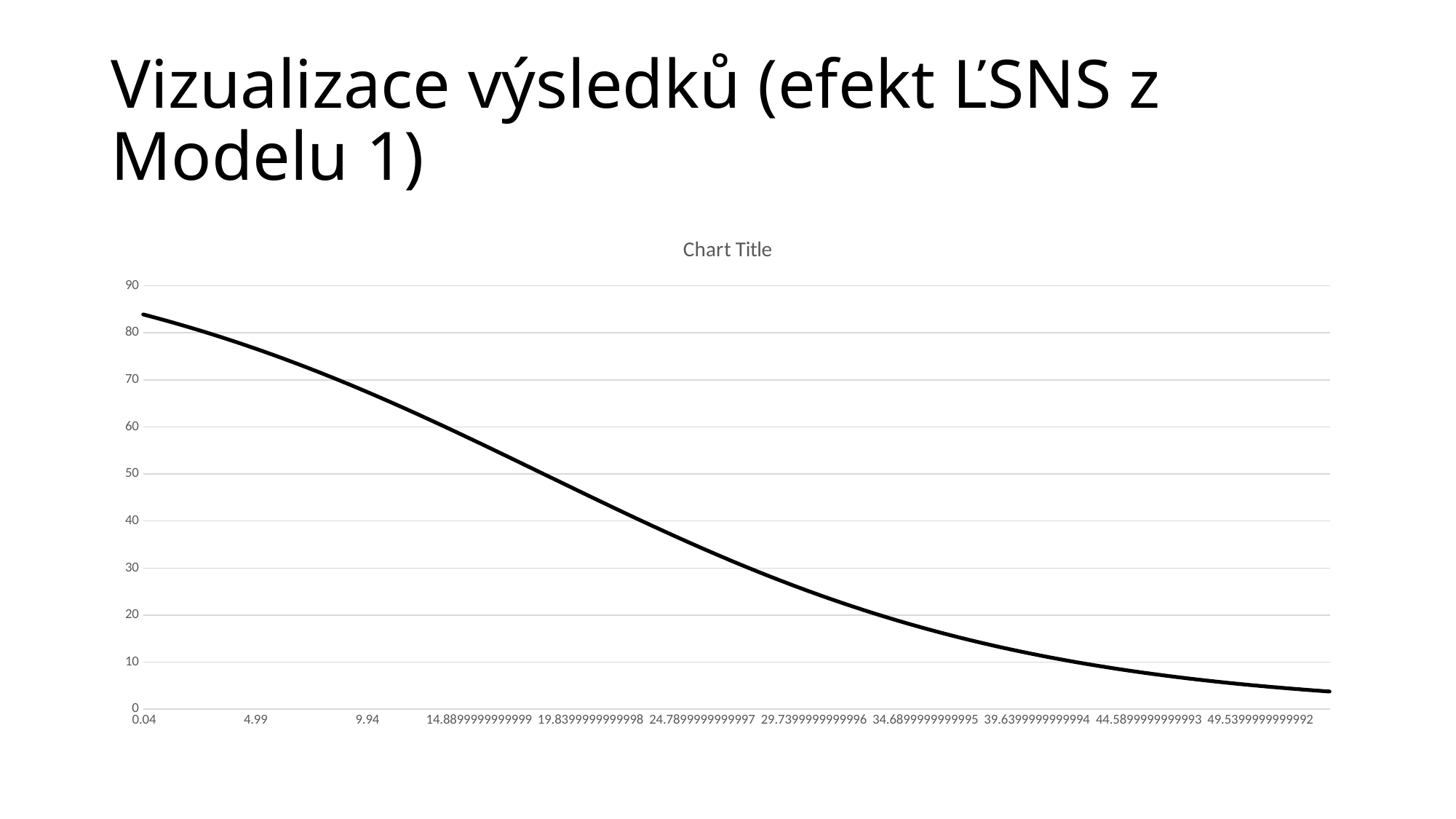
Is the value at x = 29.7399999999996 greater or less than 40? less Is the value at x = 9.94 greater or less than 80? less Is the value at x = 0.04 greater or less than 90? less What is the title printed above the chart? Chart Title Do the values rise or fall as you move from left to right along the x axis? fall What kind of chart is shown on the slide? line chart How many tick labels are shown on the x axis? 11